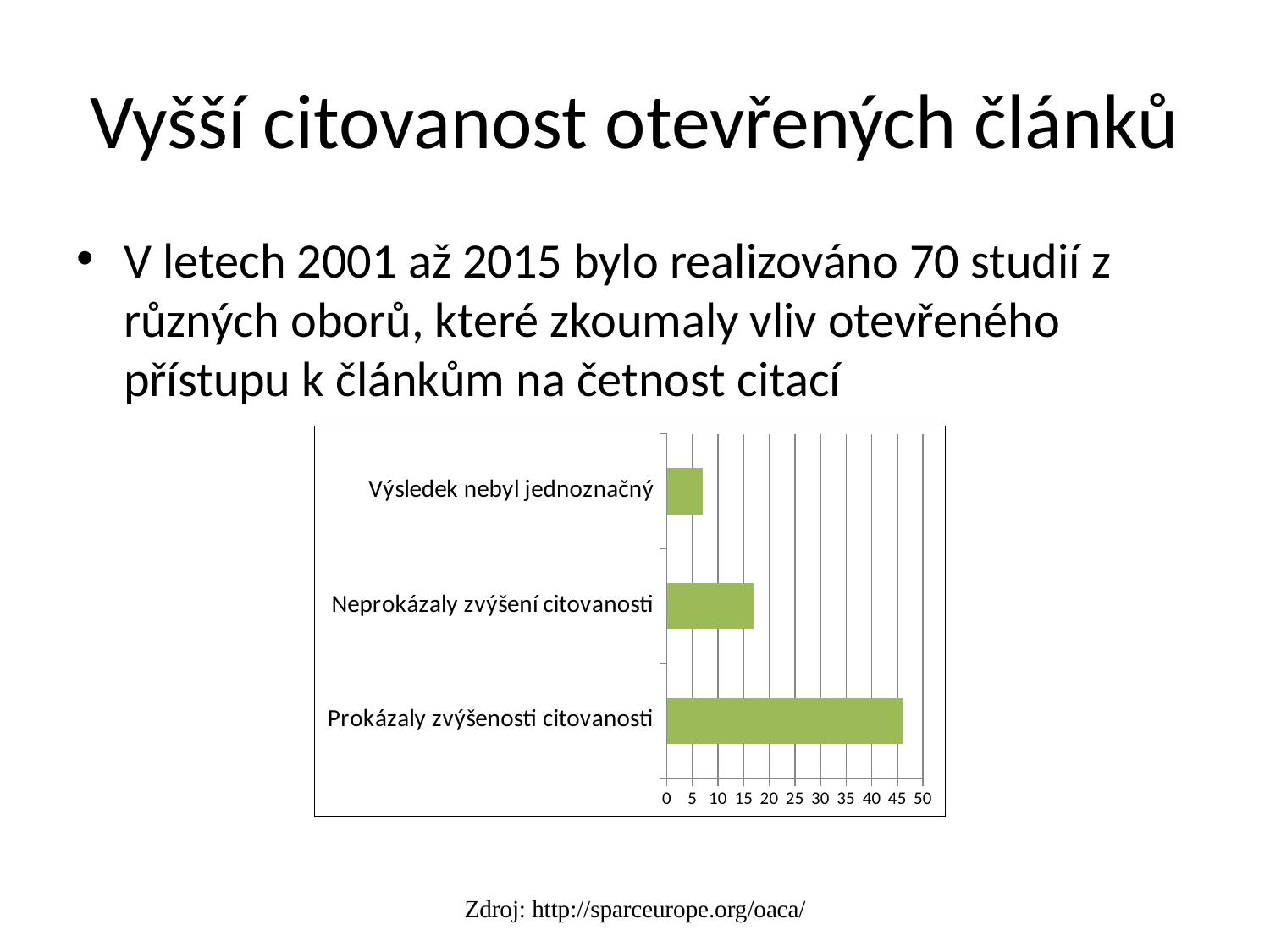
Which is larger: the value for Prokázaly zvýšenosti citovanosti or the value for Neprokázaly zvýšení citovanosti? Prokázaly zvýšenosti citovanosti Which category has the highest value in the bar chart? Prokázaly zvýšenosti citovanosti Is the value for Neprokázaly zvýšení citovanosti greater or less than 20? less Is the value for Prokázaly zvýšenosti citovanosti greater or less than 30? greater Is the value for Prokázaly zvýšenosti citovanosti greater or less than 40? greater What colour are the bars in the chart? green Which category has the lowest value in the bar chart? Výsledek nebyl jednoznačný Which is larger: the value for Neprokázaly zvýšení citovanosti or the value for Výsledek nebyl jednoznačný? Neprokázaly zvýšení citovanosti What is the highest value shown on the horizontal axis of the bar chart? 50 What kind of chart is shown on the slide? bar chart How many categories does the bar chart show? 3